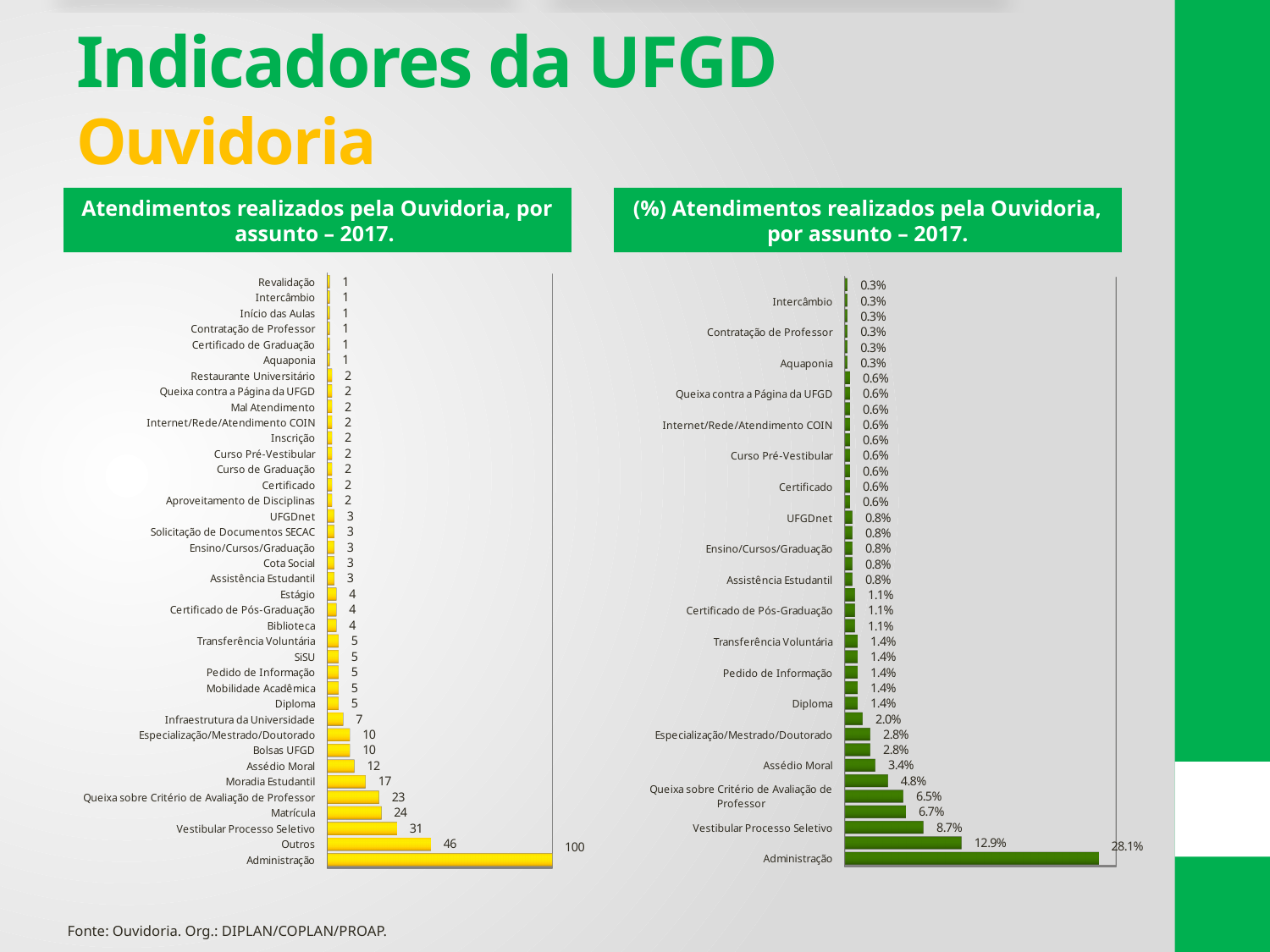
In the chart 'Atendimentos realizados pela Ouvidoria, por assunto – 2017', what is the difference between Outros and Vestibular Processo Seletivo? 15 In the chart 'Atendimentos realizados pela Ouvidoria, por assunto – 2017', what is the value for Matrícula? 24 In the chart '(%) Atendimentos realizados pela Ouvidoria, por assunto – 2017', which is larger: Queixa sobre Critério de Avaliação de Professor or Especialização/Mestrado/Doutorado? Queixa sobre Critério de Avaliação de Professor In the chart '(%) Atendimentos realizados pela Ouvidoria, por assunto – 2017', what is the value for Assédio Moral? 3.4% In the chart '(%) Atendimentos realizados pela Ouvidoria, por assunto – 2017', what is the value for Vestibular Processo Seletivo? 8.7% In the chart '(%) Atendimentos realizados pela Ouvidoria, por assunto – 2017', what is the value for Administração? 28.1% In the chart 'Atendimentos realizados pela Ouvidoria, por assunto – 2017', what is the value for Infraestrutura da Universidade? 7 In the chart 'Atendimentos realizados pela Ouvidoria, por assunto – 2017', which category has the highest value? Administração In the chart 'Atendimentos realizados pela Ouvidoria, por assunto – 2017', which is larger: Assédio Moral or Bolsas UFGD? Assédio Moral In the chart 'Atendimentos realizados pela Ouvidoria, por assunto – 2017', what is the value for Moradia Estudantil? 17 What type of chart is the left chart, 'Atendimentos realizados pela Ouvidoria, por assunto – 2017'? Bar chart In the chart 'Atendimentos realizados pela Ouvidoria, por assunto – 2017', what is the value for Administração? 100